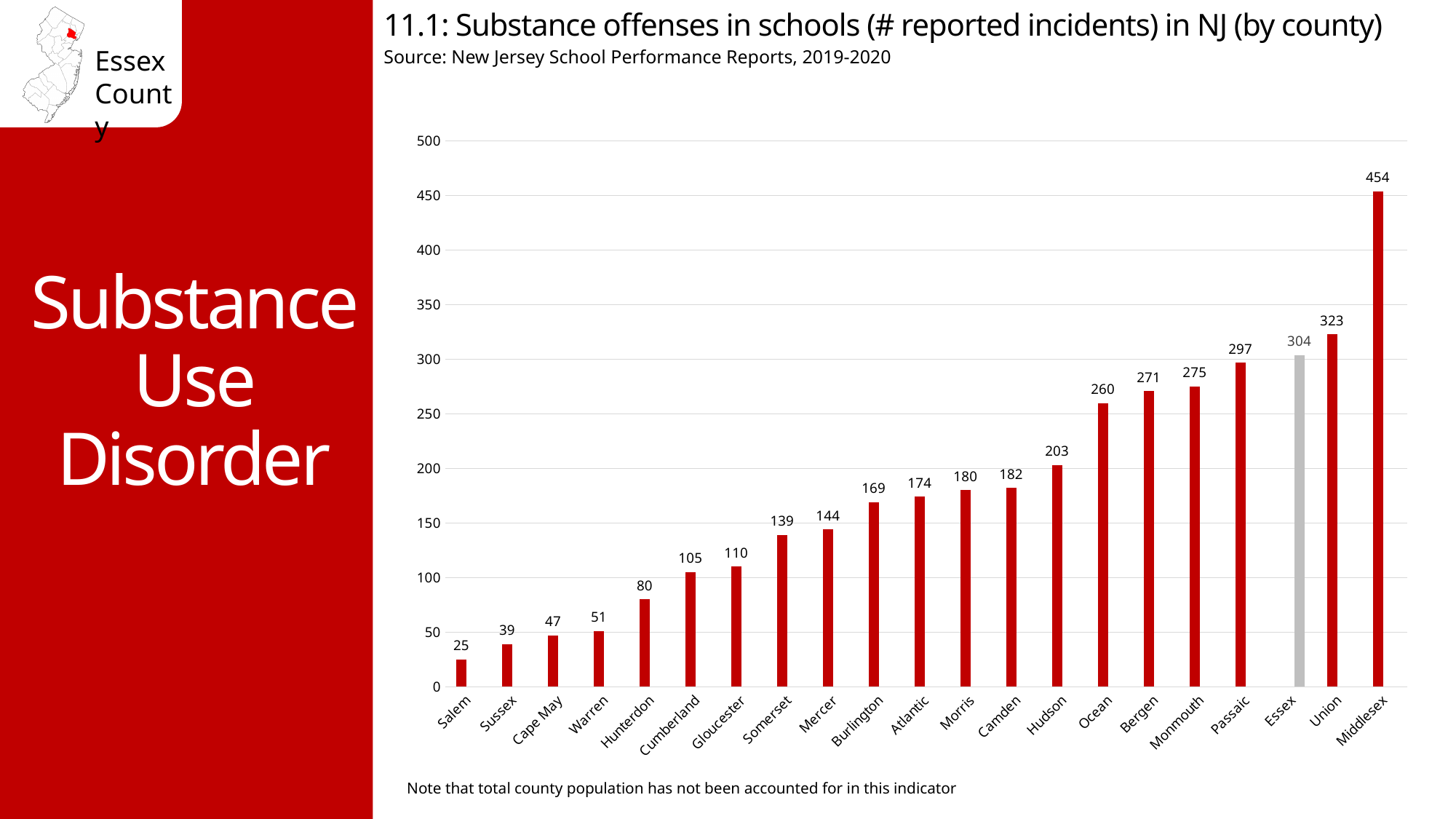
How many substance offenses in schools were reported for Essex County? 304 What is the number of reported substance offense incidents for Hudson County? 203 How many counties are shown on the chart? 21 What kind of chart is shown on the slide? Bar chart What is the difference between the values for Union and Passaic? 26 Which county has the highest number of reported substance offenses in schools? Middlesex Which county has more reported incidents, Bergen or Ocean? Bergen Which county's bar is shown in grey instead of red? Essex Do the values rise or fall moving from left to right along the x axis? Rise Is the value for Monmouth greater or less than 300? less What is the difference between the values for Middlesex and Essex? 150 Which county has the lowest number of reported substance offenses in schools? Salem